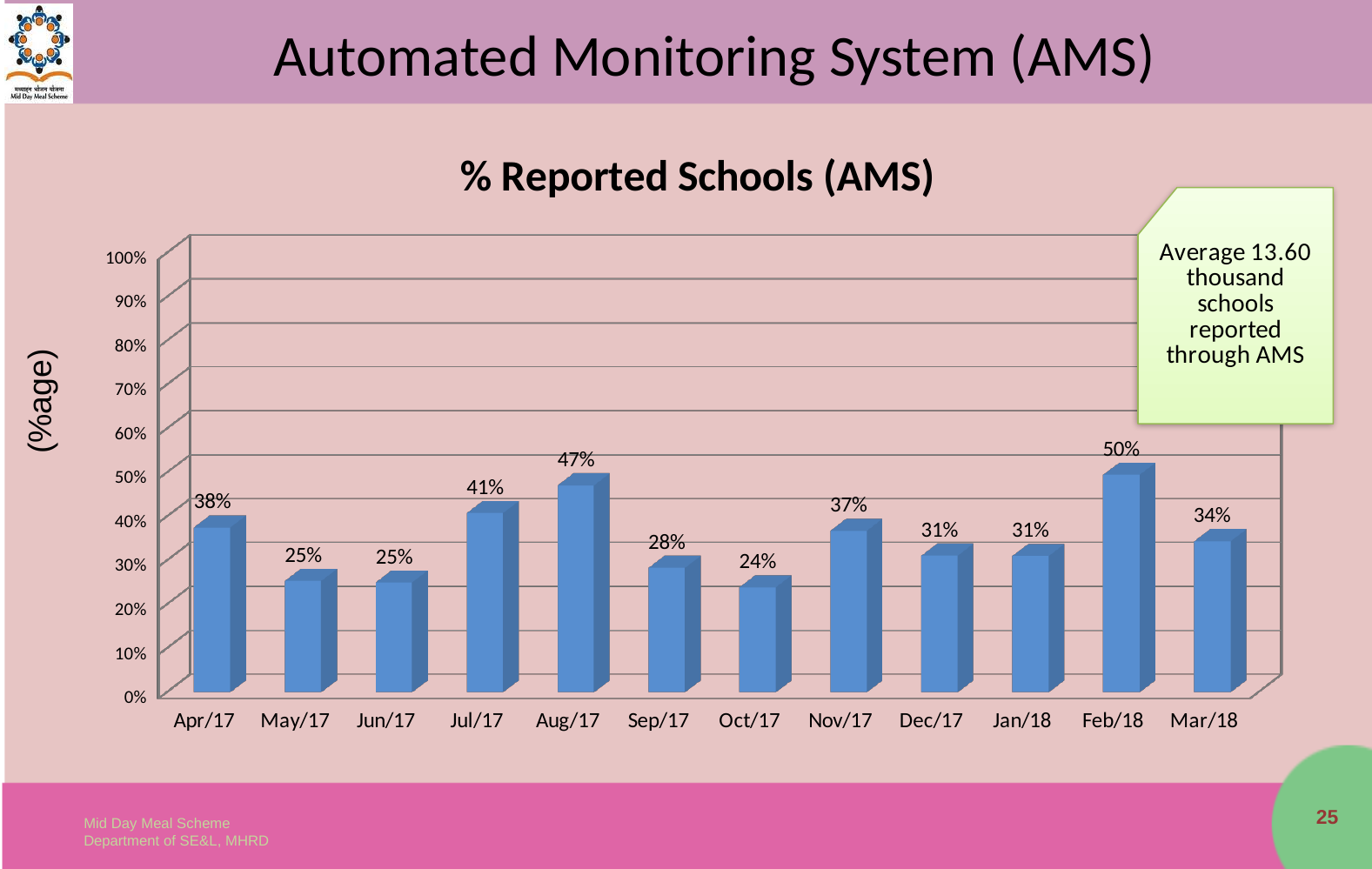
What is the difference between the values for Feb/18 and Oct/17? 26% What is the value for Oct/17? 24% Which is larger, the value for Jul/17 or the value for Nov/17? Jul/17 What is the title of the chart? % Reported Schools (AMS) What kind of chart is shown on the slide? bar chart What is the value for Mar/18? 34% Which month has the lowest percentage of reported schools? Oct/17 What is the value for Aug/17? 47% Which month has the highest percentage of reported schools? Feb/18 How many months are shown on the x axis? 12 According to the callout box, how many schools on average reported through AMS? 13.60 thousand Is the value for Apr/17 greater or less than 30%? greater